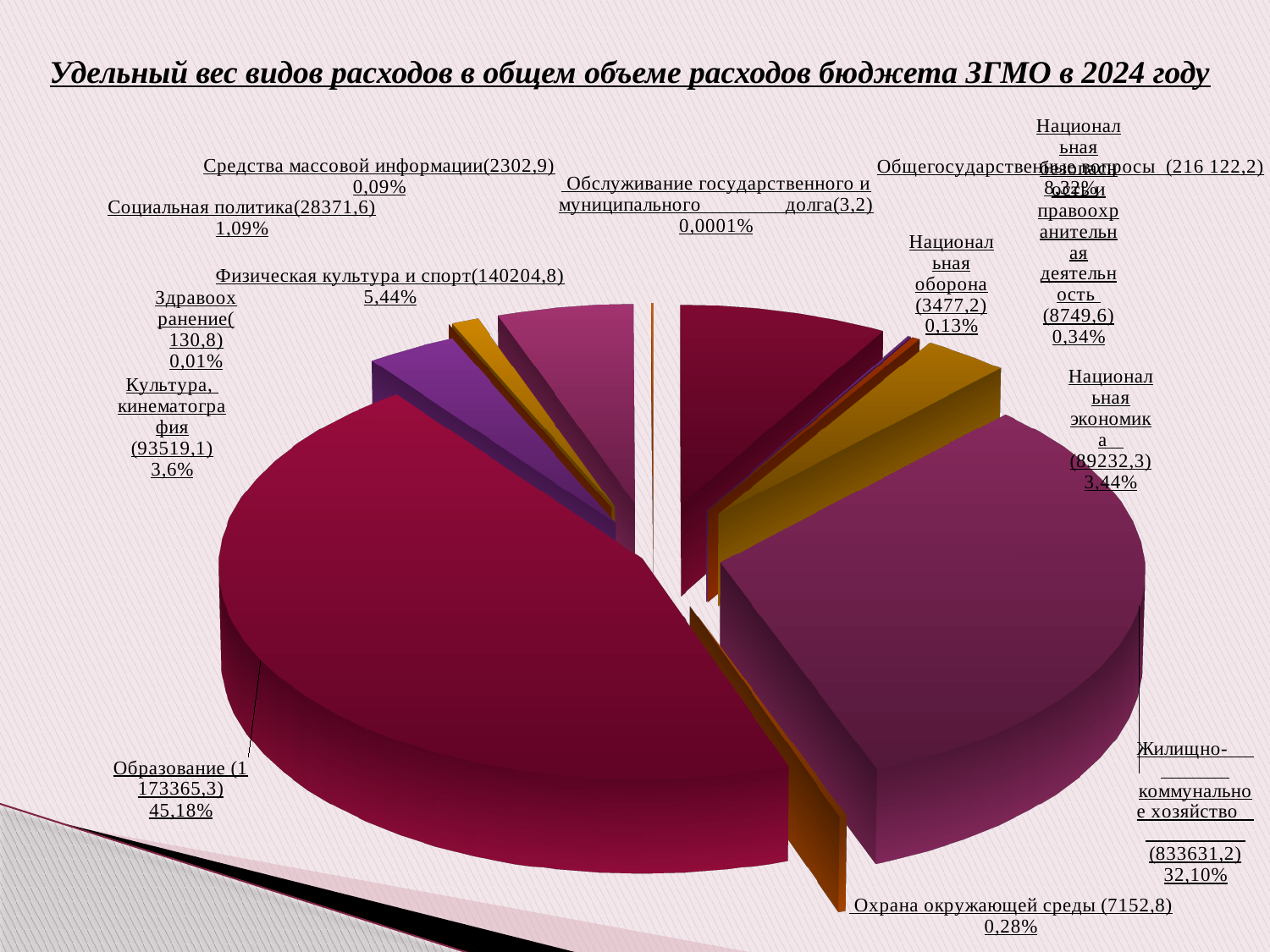
How many expenditure categories are shown in the pie chart? 13 What share of the budget expenditures does Образование account for? 45,18% What percentage is shown for Общегосударственные вопросы? 8,32% What kind of chart is shown on the slide? pie chart What share of the budget expenditures does Жилищно-коммунальное хозяйство account for? 32,10% What is the difference in percentage points between Образование and Жилищно-коммунальное хозяйство? 13,08 What is the value shown for Охрана окружающей среды? 7152,8 Which category has the smallest share of expenditures? Обслуживание государственного и муниципального долга Which has a larger share: Национальная экономика or Культура, кинематография? Культура, кинематография Which category has the largest share of expenditures? Образование What is the value shown for Физическая культура и спорт? 140204,8 What is the title of the chart? Удельный вес видов расходов в общем объеме расходов бюджета ЗГМО в 2024 году